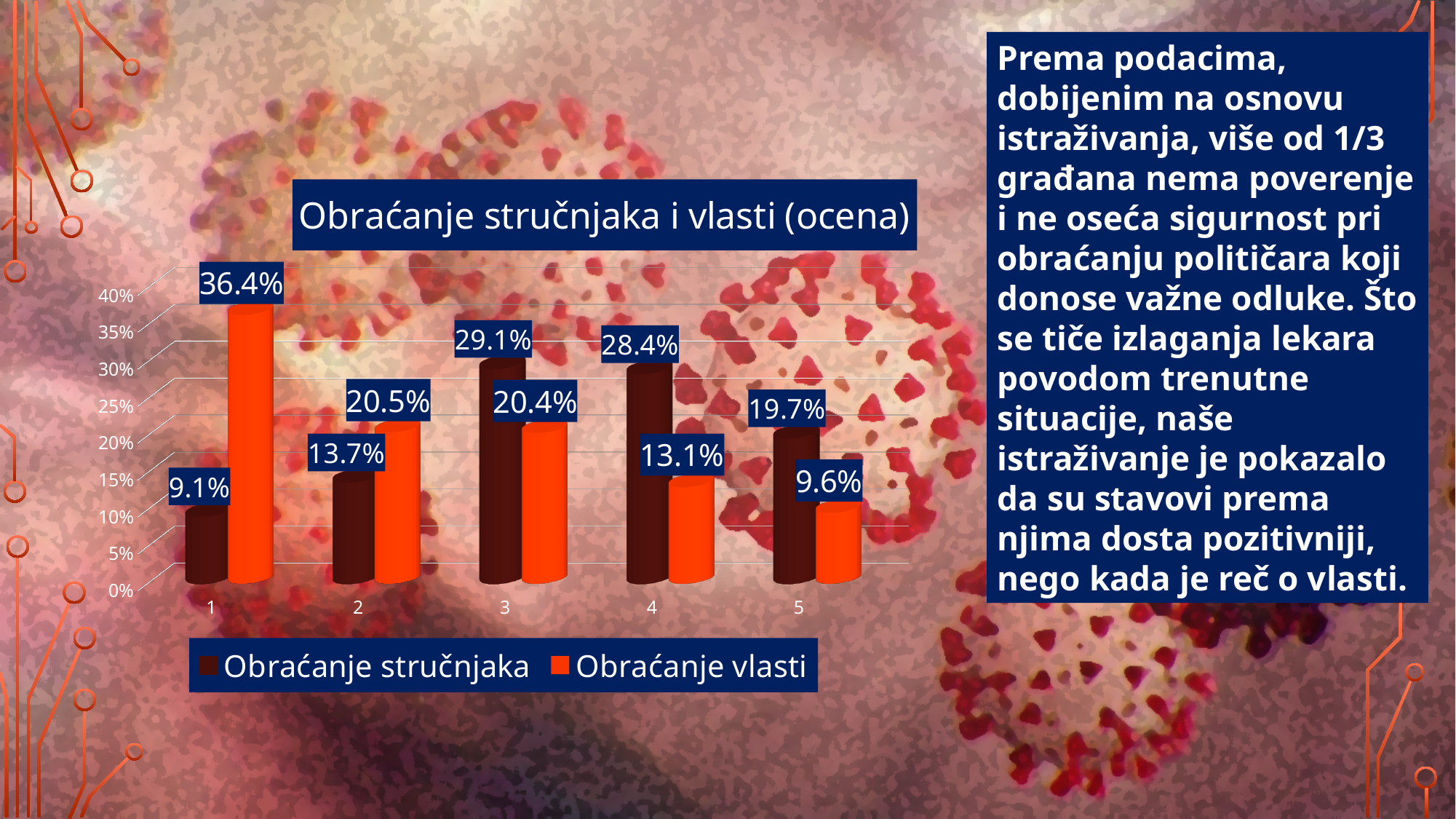
How many categories are shown on the x axis? 5 Which category has the highest value for Obraćanje vlasti? 1 What is the value for Obraćanje vlasti at category 1? 36.4% What is the difference between Obraćanje vlasti and Obraćanje stručnjaka at category 1? 27.3% Does the value for Obraćanje vlasti rise or fall from category 1 to category 5? fall How many series does the legend list? 2 At category 4, which series has the larger value, Obraćanje stručnjaka or Obraćanje vlasti? Obraćanje stručnjaka What type of chart is shown on the slide? bar chart What is the value for Obraćanje stručnjaka at category 5? 19.7% Which category has the lowest value for Obraćanje stručnjaka? 1 What is the value for Obraćanje stručnjaka at category 3? 29.1% What is the title of the chart? Obraćanje stručnjaka i vlasti (ocena)